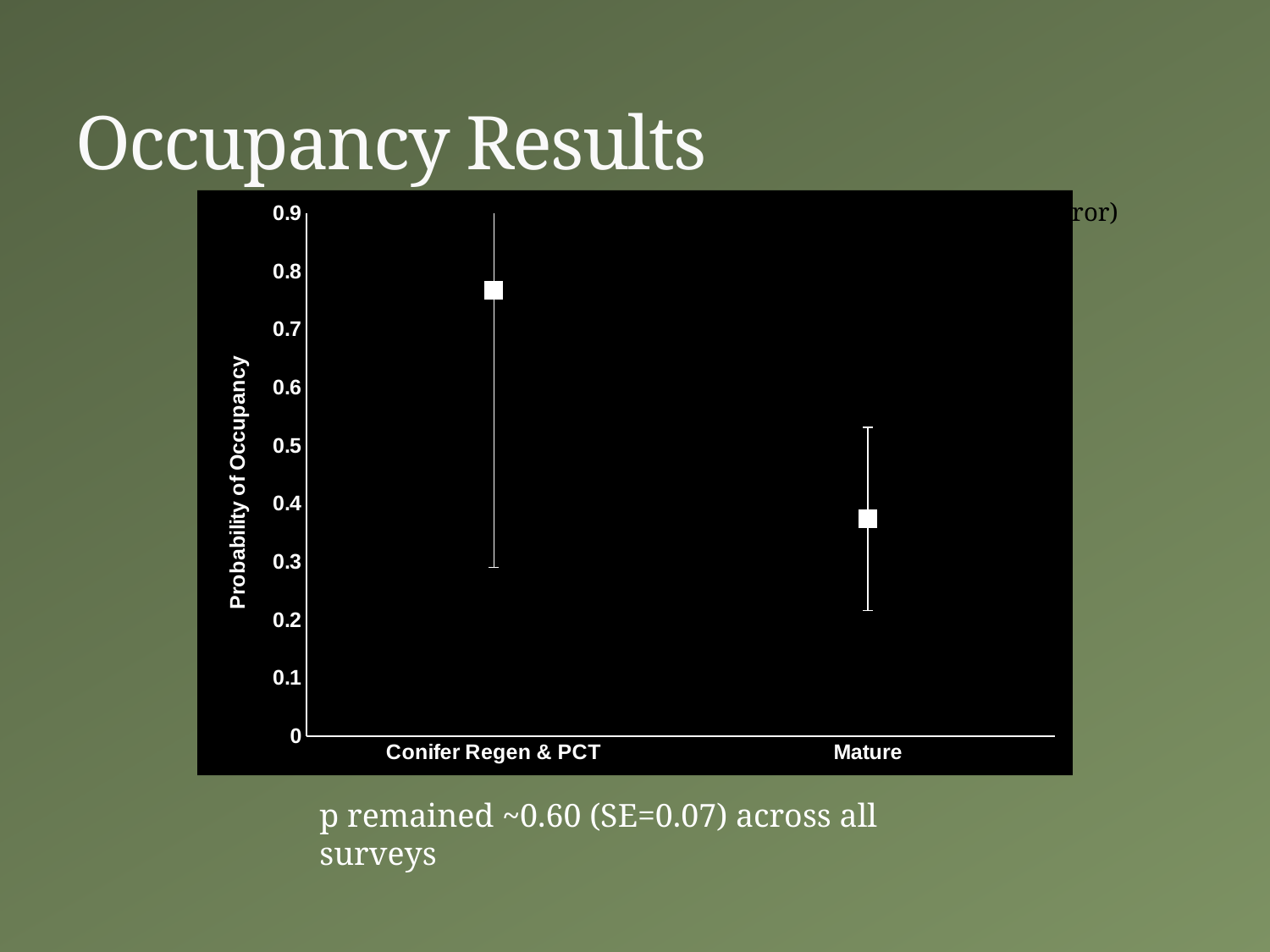
Is the probability of occupancy for Conifer Regen & PCT greater or less than 0.7? greater Which category has the lowest probability of occupancy? Mature Is the probability of occupancy for Mature greater or less than 0.5? less What is the label on the y axis of the chart? Probability of Occupancy Is the probability of occupancy for Conifer Regen & PCT greater or less than 0.8? less Which category has the highest probability of occupancy? Conifer Regen & PCT What is the highest value shown on the y axis of the chart? 0.9 What kind of chart is shown on the slide? Scatter chart with error bars Which has a higher probability of occupancy, Conifer Regen & PCT or Mature? Conifer Regen & PCT How many categories are shown on the x axis of the chart? 2